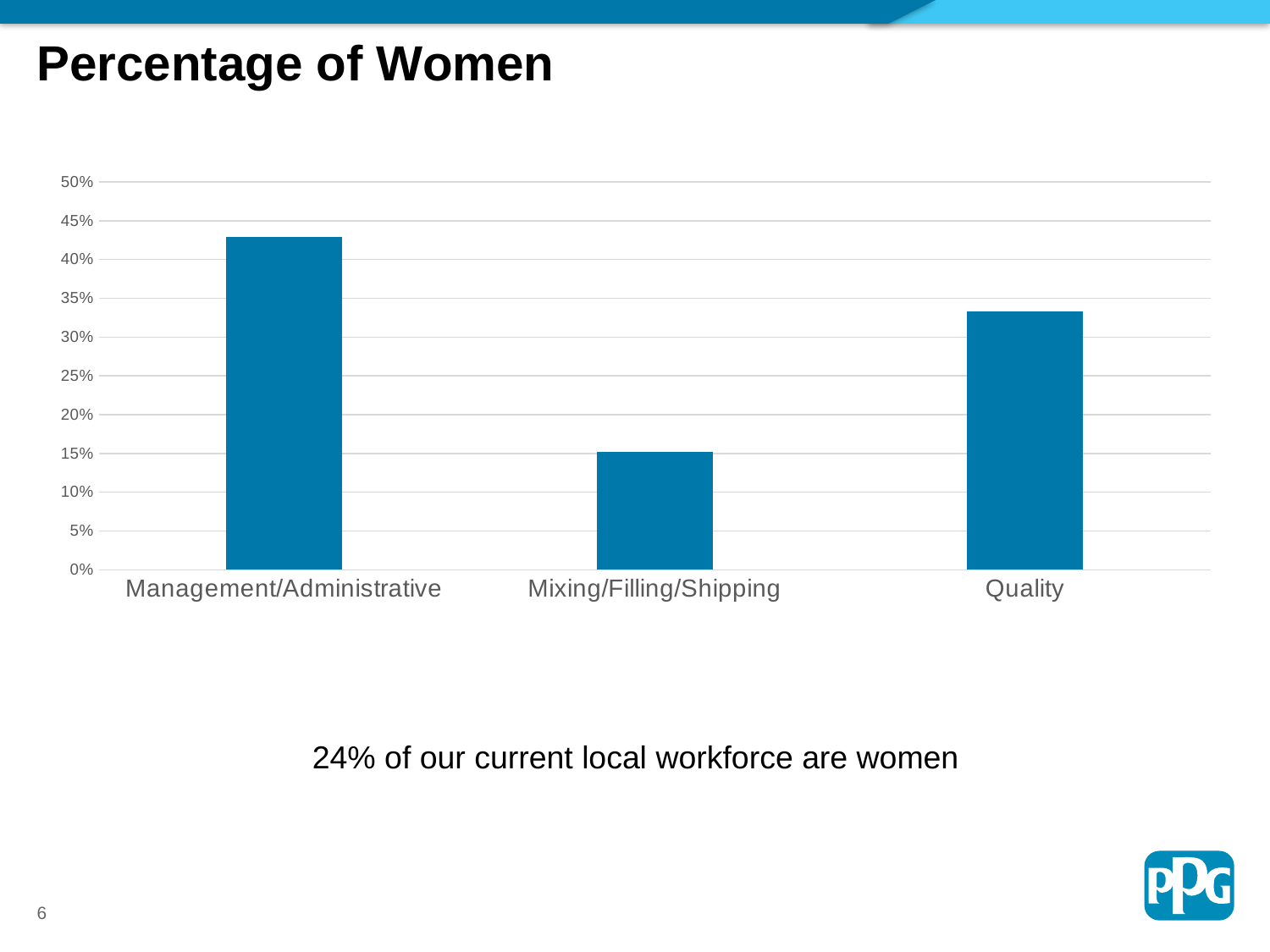
Is the value for Quality greater or less than 30%? greater Is the value for Mixing/Filling/Shipping greater or less than 20%? less Which has a higher percentage of women, Management/Administrative or Quality? Management/Administrative Which category has the lowest percentage of women? Mixing/Filling/Shipping How many categories are shown on the x axis of the chart? 3 Is the value for Management/Administrative greater or less than 40%? greater Which has a higher percentage of women, Quality or Mixing/Filling/Shipping? Quality Which category has the highest percentage of women? Management/Administrative What is the title of the slide containing the chart? Percentage of Women What is the highest value shown on the y axis of the chart? 50% What kind of chart is shown on the slide? bar chart